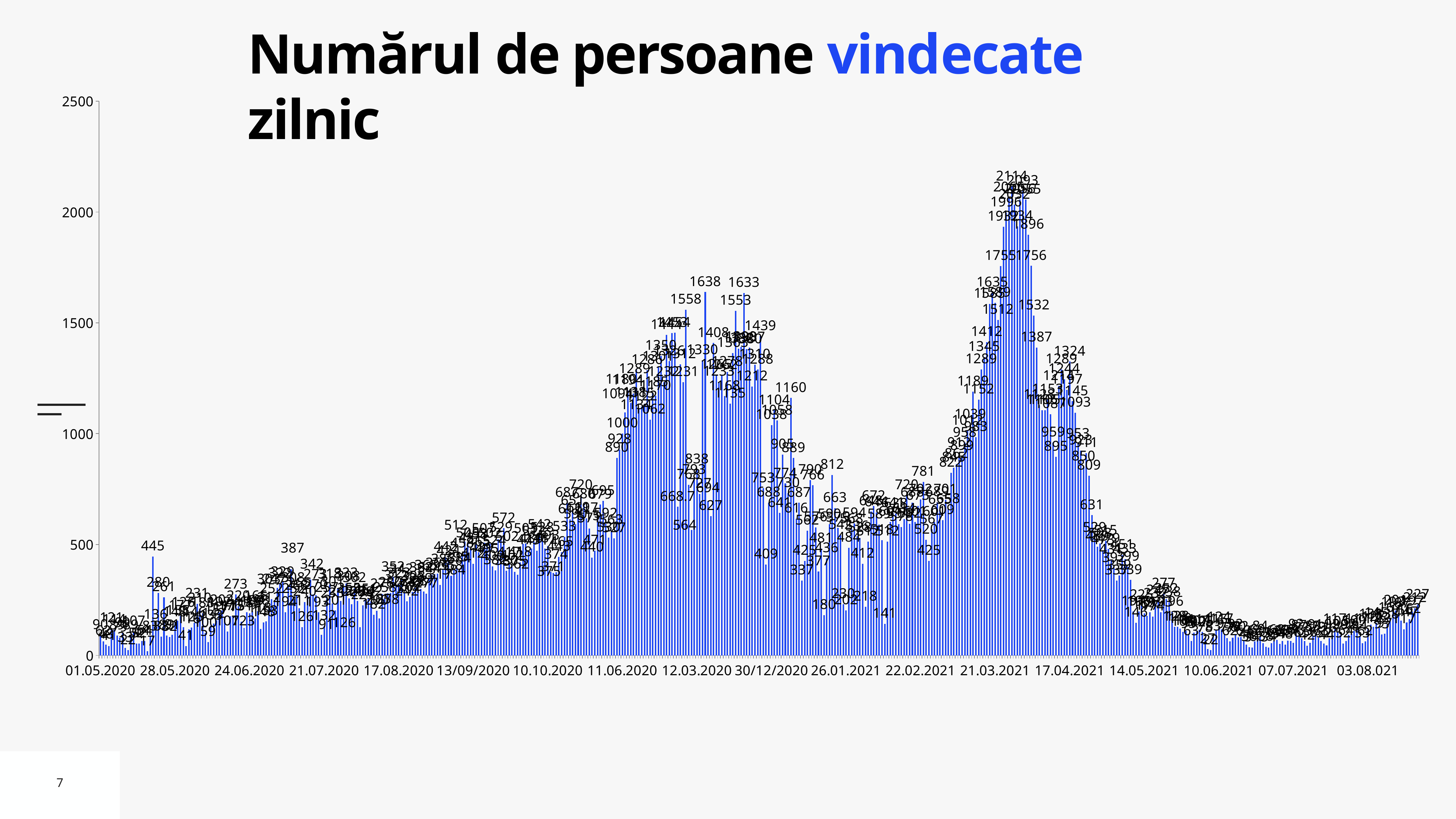
Is the highest value on the chart greater or less than 2000? greater What is the difference between the overall peak value of 2114 and the earlier peak value of 1638? 476 Do the values rise or fall between 21.03.2021 and 14.05.2021? fall What kind of chart is shown on the slide? bar chart What is the highest tick value shown on the vertical axis? 2500 Is the value for 03.08.2021 greater or less than 500? less What is the highest daily value labelled on the chart? 2114 What is the title of the chart? Numărul de persoane vindecate zilnic Which is larger: the peak value around 12.03.2020 (1638) or the peak value between 21.03.2021 and 17.04.2021 (2114)? 2114 Is the value for 01.05.2020 greater or less than 500? less How many date labels are shown along the horizontal axis? 18 Do the values generally rise or fall between 01.05.2020 and 13/09/2020? rise